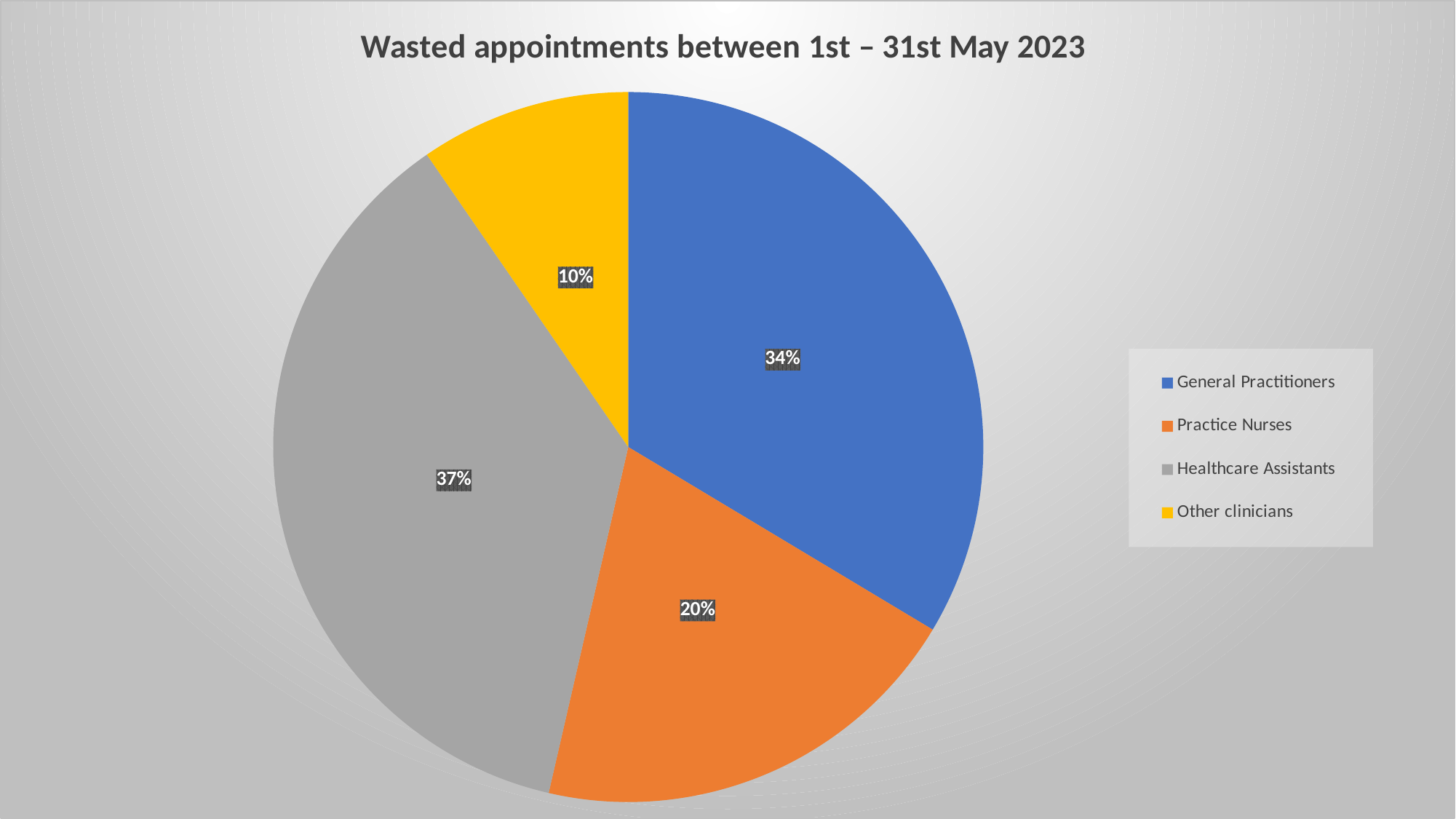
What is the difference in percentage points between the Healthcare Assistants share and the Practice Nurses share? 17 What is the title of the chart? Wasted appointments between 1st – 31st May 2023 What share of wasted appointments is attributed to Healthcare Assistants? 37% How many categories does the pie chart show? 4 What share of wasted appointments is attributed to Practice Nurses? 20% Which category has the largest share of wasted appointments? Healthcare Assistants What colour is the slice for Other clinicians? yellow Which has a larger share of wasted appointments, General Practitioners or Practice Nurses? General Practitioners Which category has the smallest share of wasted appointments? Other clinicians What share of wasted appointments is attributed to Other clinicians? 10% What kind of chart is shown on the slide? pie chart